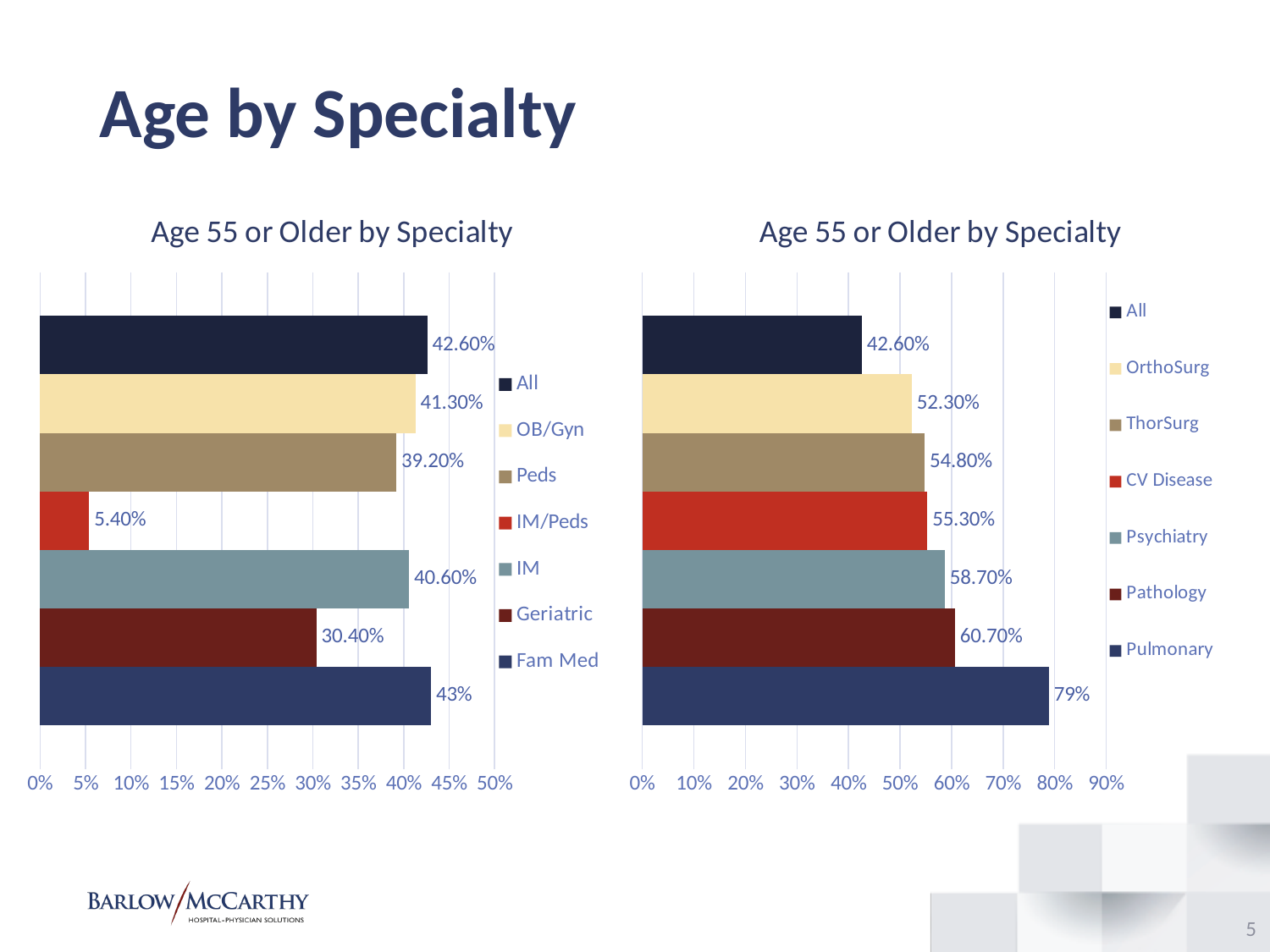
In the right chart, what is the difference between Pulmonary and All? 36.40% How many entries does the legend of the right chart list? 7 In the left chart, what is the value for IM/Peds? 5.40% In the right chart, what is the value for Pulmonary? 79% What is the title of the right chart? Age 55 or Older by Specialty In the right chart, is the value for Pathology greater or less than 50%? greater In the right chart, what is the value for Psychiatry? 58.70% In the left chart, which is larger, the value for OB/Gyn or the value for Peds? OB/Gyn In the left chart, what is the value for Geriatric? 30.40% In the left chart, which specialty has the lowest value? IM/Peds In the right chart, which specialty has the highest value? Pulmonary What kind of chart is the left chart? Bar chart